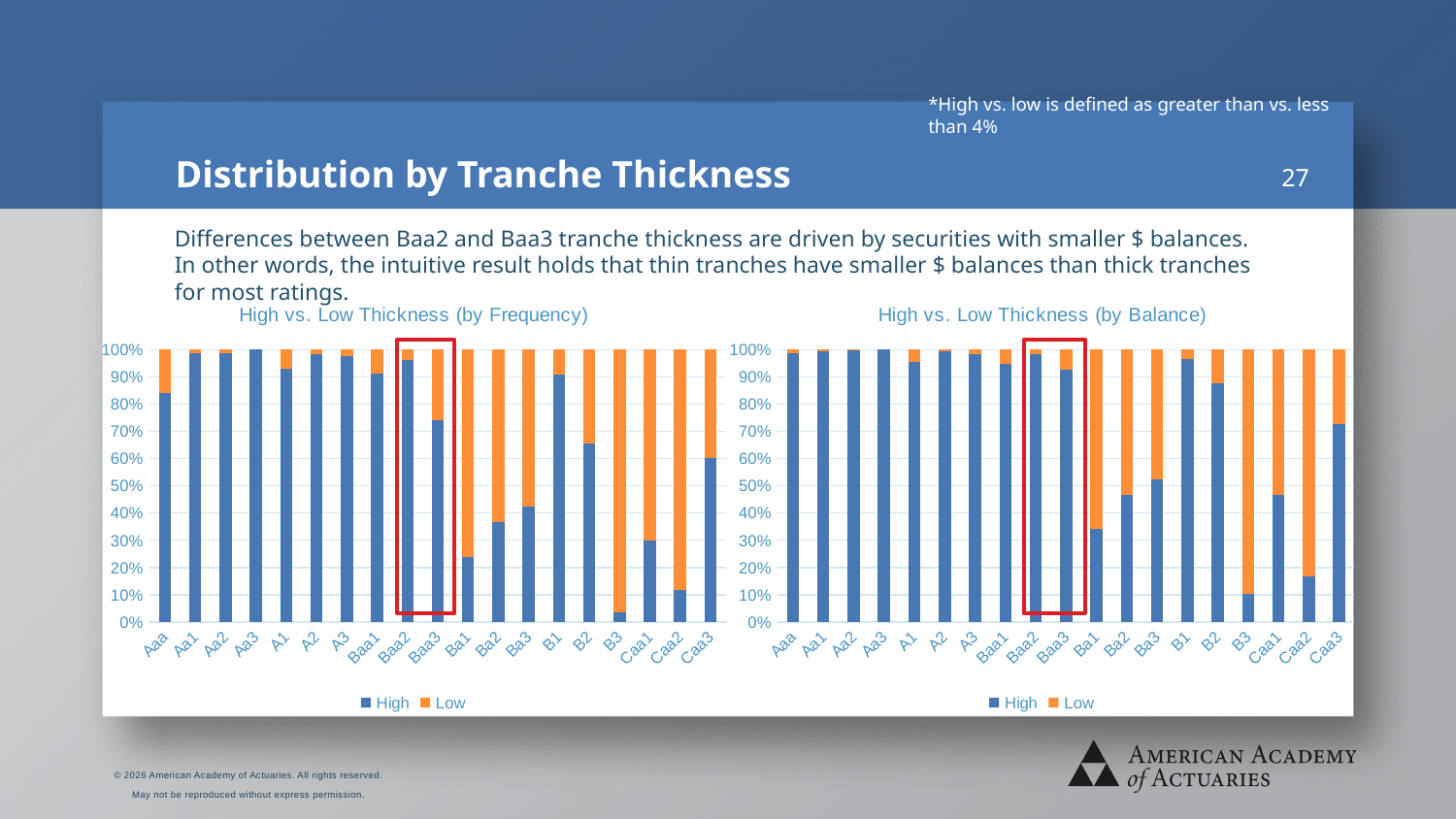
In the 'High vs. Low Thickness (by Balance)' chart, what is the total of the stacked bar for Ba1? 100% In the 'High vs. Low Thickness (by Balance)' chart, which colour represents the Low series? Orange In the 'High vs. Low Thickness (by Frequency)' chart, is the High value for Ba1 greater or less than 50%? less What kind of chart is the 'High vs. Low Thickness (by Frequency)' chart? Stacked bar chart In the 'High vs. Low Thickness (by Balance)' chart, which has the larger High value, Aaa or Ba2? Aaa In the 'High vs. Low Thickness (by Frequency)' chart, is the High value for B3 greater or less than 10%? less In the 'High vs. Low Thickness (by Frequency)' chart, which has the larger High value, Baa3 or Ba1? Baa3 In the 'High vs. Low Thickness (by Balance)' chart, is the High value for Ba1 greater or less than 50%? less How many rating categories are shown on the x axis of the 'High vs. Low Thickness (by Balance)' chart? 19 In the 'High vs. Low Thickness (by Frequency)' chart, which rating category has the lowest High value? B3 How many series does the legend of the 'High vs. Low Thickness (by Frequency)' chart list? 2